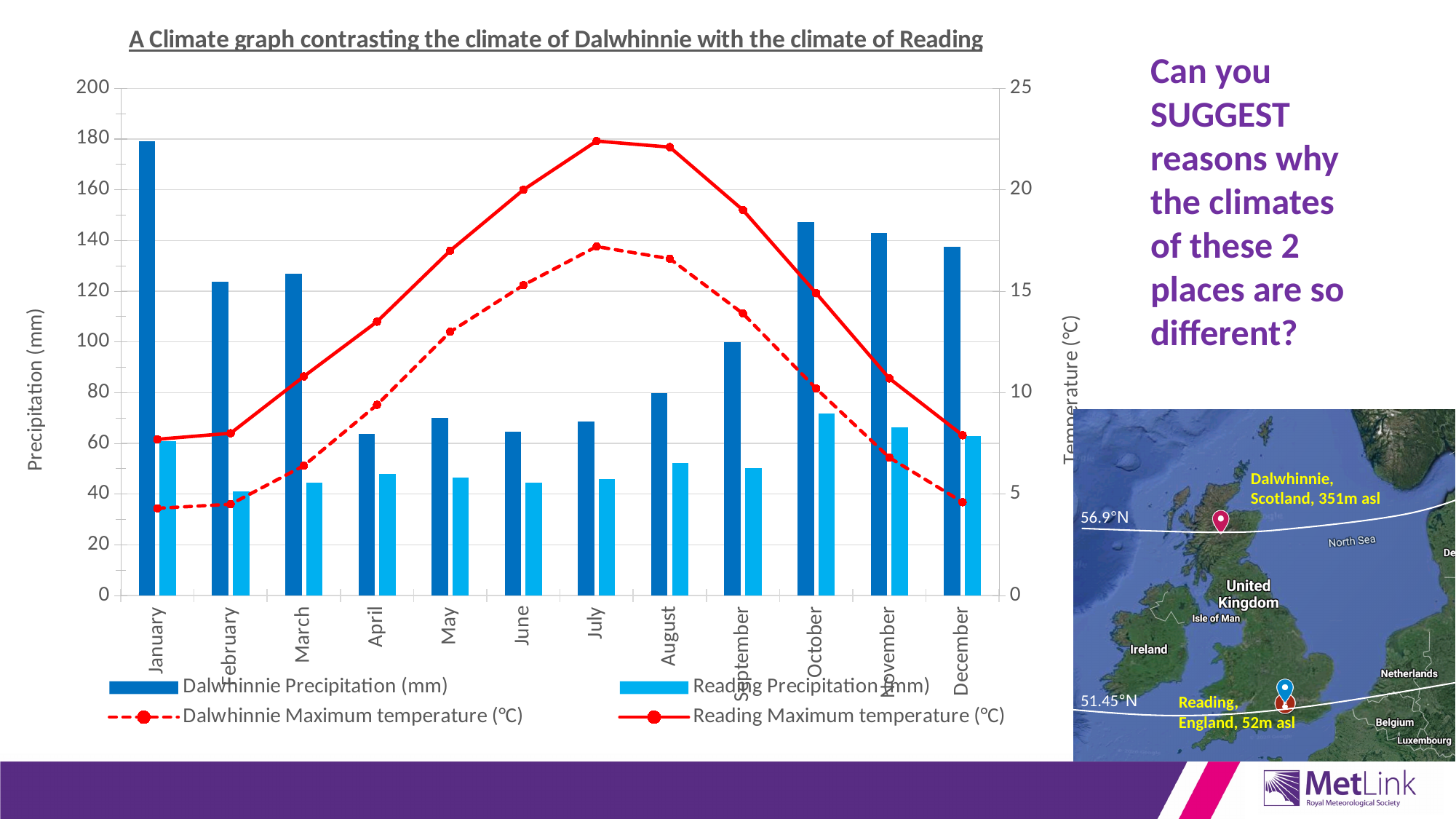
What kind of chart is shown on the slide? A combined bar and line chart Is the Reading maximum temperature for July greater or less than 20? greater How many series does the legend list? 4 Is the Dalwhinnie precipitation for January greater or less than 160? greater In which month is Dalwhinnie precipitation highest? January How many months are shown along the x axis? 12 In which month is Reading precipitation highest? October Which is larger in January: Dalwhinnie precipitation or Reading precipitation? Dalwhinnie precipitation Is the Reading precipitation for October greater or less than 60? greater Does the Reading maximum temperature rise or fall from January to July? Rises Which is higher in July: Reading maximum temperature or Dalwhinnie maximum temperature? Reading maximum temperature